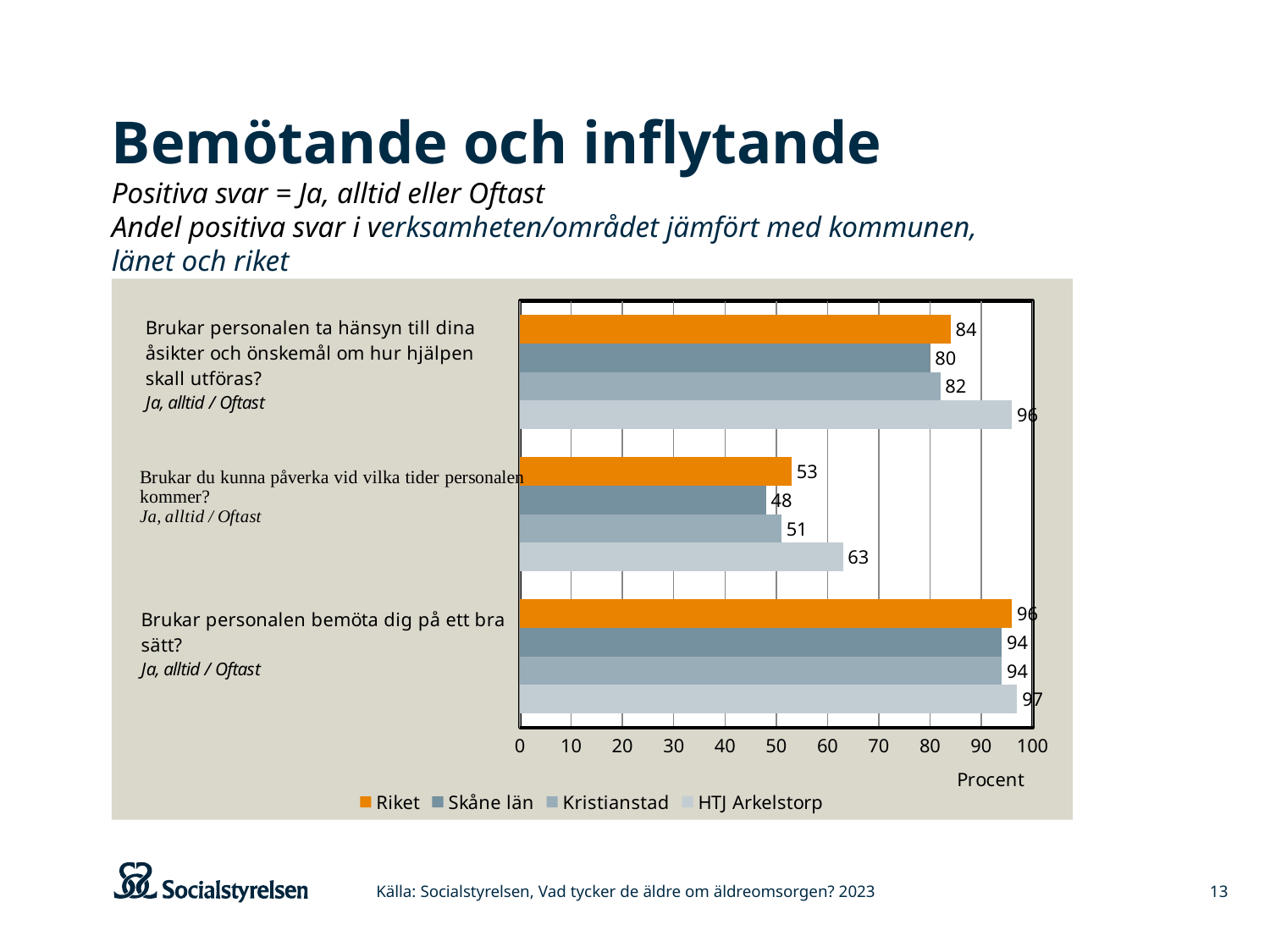
On the question "Brukar du kunna påverka vid vilka tider personalen kommer?", which is larger: Riket or Kristianstad? Riket Which series has the highest value on the question "Brukar personalen ta hänsyn till dina åsikter och önskemål om hur hjälpen skall utföras?"? HTJ Arkelstorp What is the difference between HTJ Arkelstorp and Riket on the question "Brukar du kunna påverka vid vilka tider personalen kommer?"? 10 How many questions (categories) are shown in the chart? 3 What is the value for Riket on the question "Brukar personalen ta hänsyn till dina åsikter och önskemål om hur hjälpen skall utföras?"? 84 What is the value for Skåne län on the question "Brukar personalen bemöta dig på ett bra sätt?"? 94 What kind of chart is shown on the slide? Bar chart What is the value for HTJ Arkelstorp on the question "Brukar du kunna påverka vid vilka tider personalen kommer?"? 63 What unit is labelled on the horizontal axis of the chart? Procent How many series does the legend list? 4 Which series has the lowest value on the question "Brukar du kunna påverka vid vilka tider personalen kommer?"? Skåne län What is the difference between HTJ Arkelstorp and Skåne län on the question "Brukar personalen ta hänsyn till dina åsikter och önskemål om hur hjälpen skall utföras?"? 16